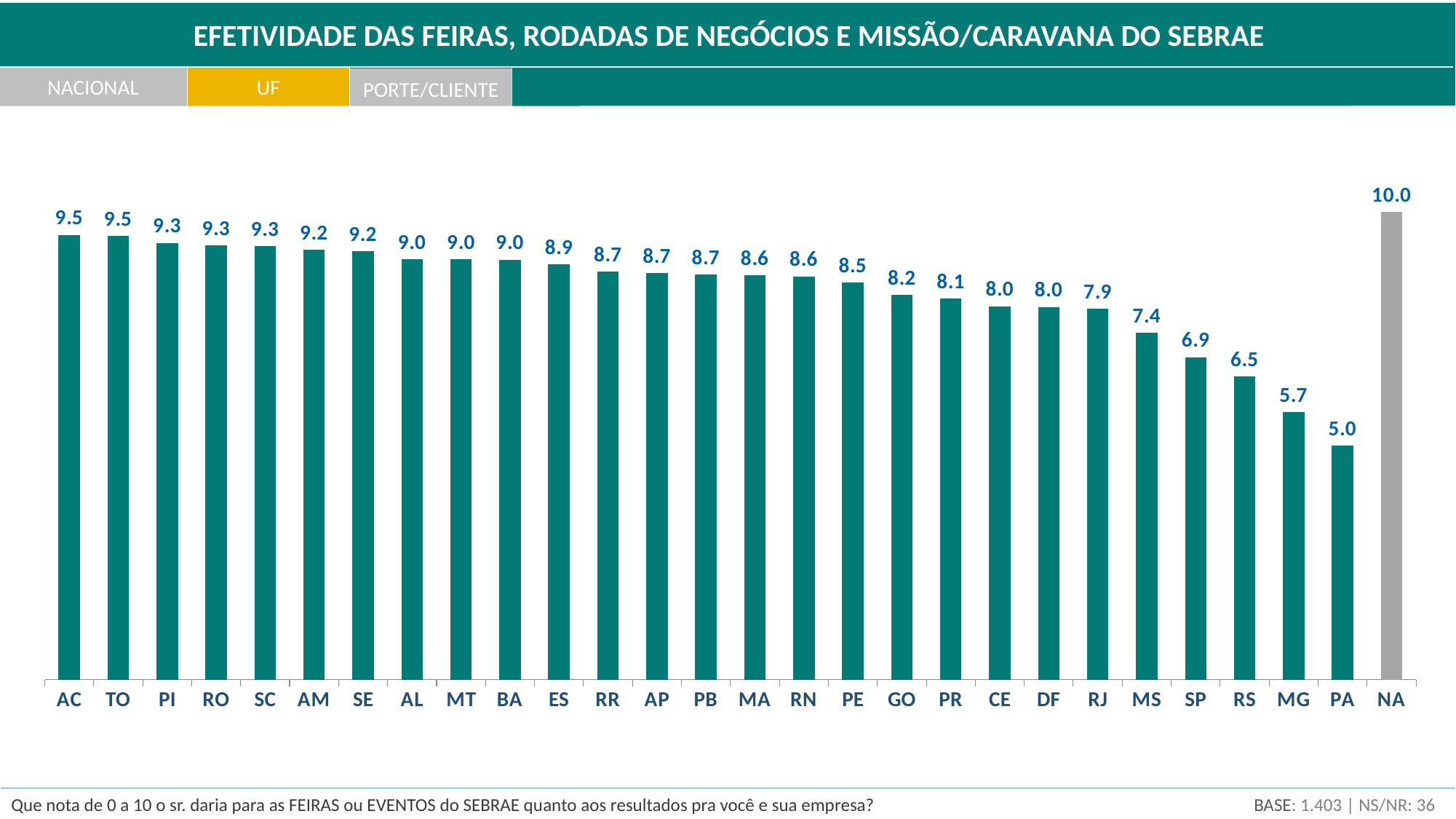
How many categories are shown on the x axis? 28 What is the value for MG? 5.7 What is the difference between the values for RJ and MS? 0.5 What kind of chart is shown on the slide? Bar chart What is the value for NA? 10.0 Which has a larger value, RS or PE? PE Which category has the lowest value? PA What is the value for SP? 6.9 What is the value for GO? 8.2 Which bar is shown in grey rather than teal? NA Which category has the highest value? NA What is the difference between the values for AC and PA? 4.5